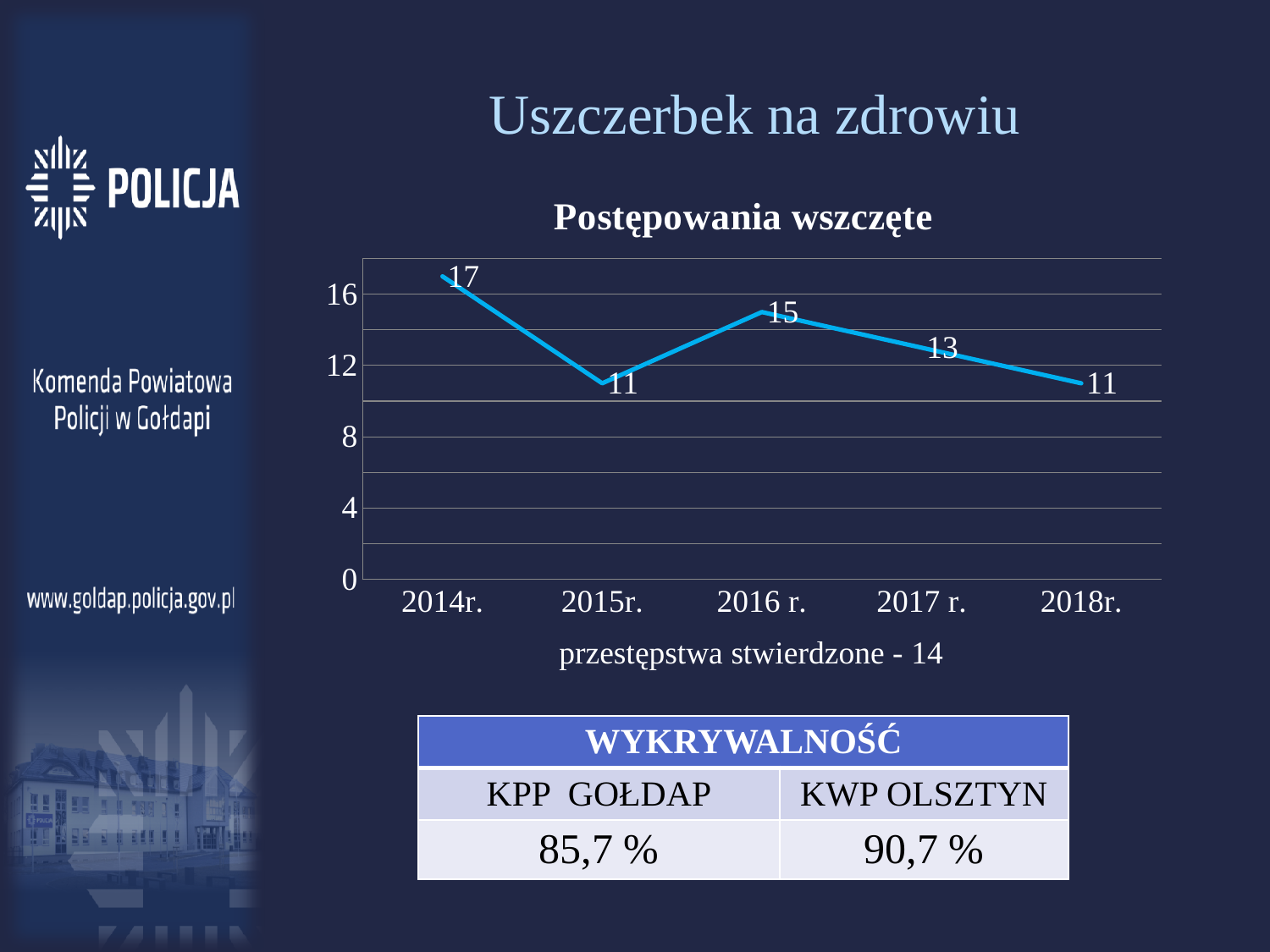
What is the difference between the values for 2016 r. and 2018r. in the 'Postępowania wszczęte' chart? 4 Which is larger in the 'Postępowania wszczęte' chart, the value for 2016 r. or the value for 2017 r.? 2016 r. Is the value for 2015r. in the 'Postępowania wszczęte' chart greater or less than 12? less How many years are plotted in the 'Postępowania wszczęte' chart? 5 What is the value for 2016 r. in the 'Postępowania wszczęte' chart? 15 What kind of chart is 'Postępowania wszczęte'? line chart Does the value in the 'Postępowania wszczęte' chart rise or fall from 2016 r. to 2018r.? fall What is the value for 2017 r. in the 'Postępowania wszczęte' chart? 13 What is the title of the chart on the slide? Postępowania wszczęte What is the difference between the values for 2014r. and 2015r. in the 'Postępowania wszczęte' chart? 6 Which year has the highest value in the 'Postępowania wszczęte' chart? 2014r. What is the value for 2014r. in the 'Postępowania wszczęte' chart? 17